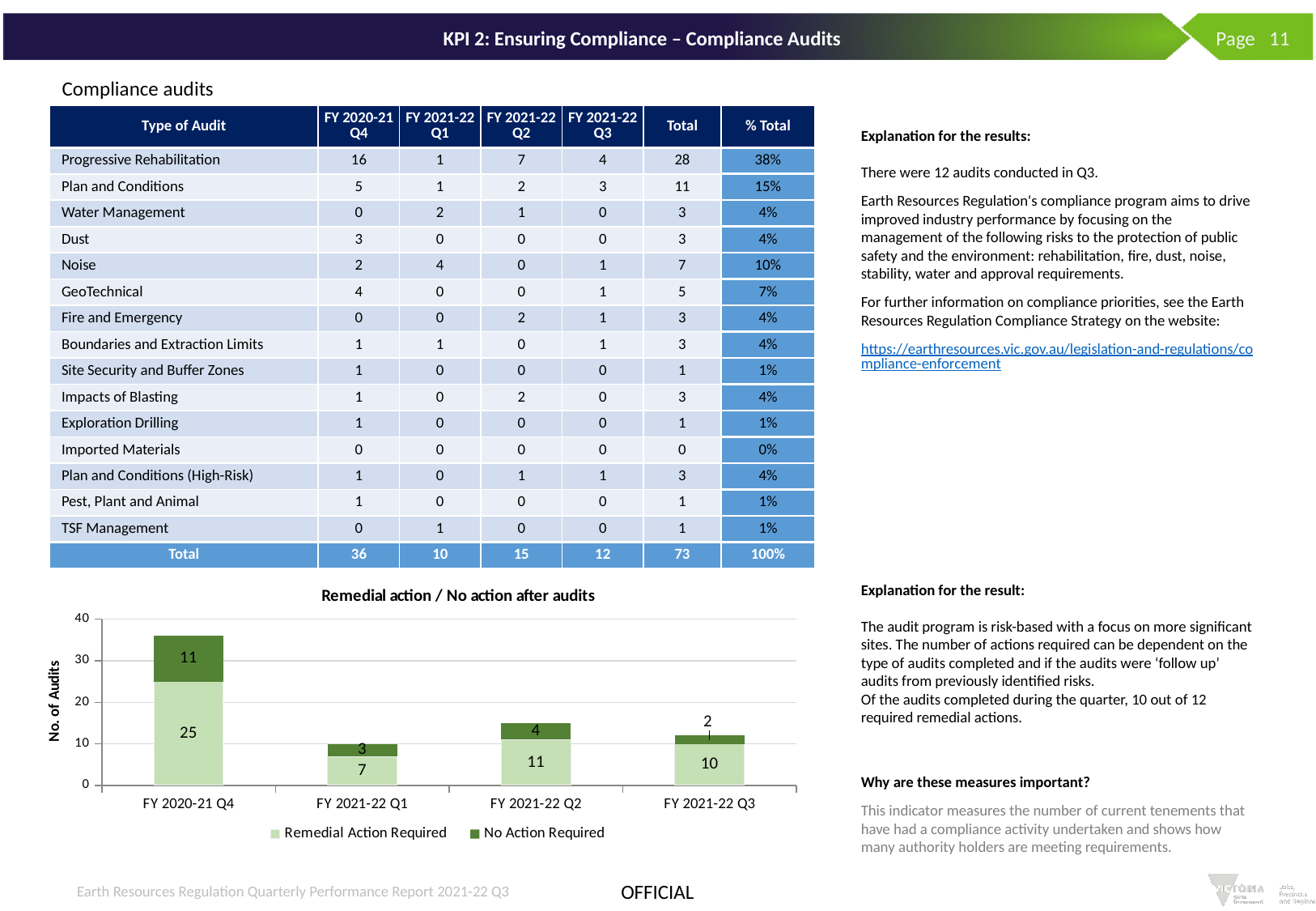
In the "Remedial action / No action after audits" chart, which quarter has the lowest No Action Required value? FY 2021-22 Q3 In the "Remedial action / No action after audits" chart, what is the total height of the stacked bar for FY 2021-22 Q2? 15 In the "Remedial action / No action after audits" chart, what is the value for No Action Required in FY 2021-22 Q2? 4 What is the y-axis label of the "Remedial action / No action after audits" chart? No. of Audits How many series does the legend of the "Remedial action / No action after audits" chart list? 2 What type of chart is shown under the title "Remedial action / No action after audits"? Stacked bar chart In the "Remedial action / No action after audits" chart, which quarter has the highest Remedial Action Required value? FY 2020-21 Q4 In the "Remedial action / No action after audits" chart, what is the difference between Remedial Action Required in FY 2020-21 Q4 and in FY 2021-22 Q1? 18 In the "Remedial action / No action after audits" chart, what is the value for No Action Required in FY 2021-22 Q3? 2 In the "Remedial action / No action after audits" chart, is the Remedial Action Required value larger in FY 2021-22 Q2 or FY 2021-22 Q3? FY 2021-22 Q2 How many quarters are shown on the x axis of the "Remedial action / No action after audits" chart? 4 In the "Remedial action / No action after audits" chart, what is the value for Remedial Action Required in FY 2020-21 Q4? 25